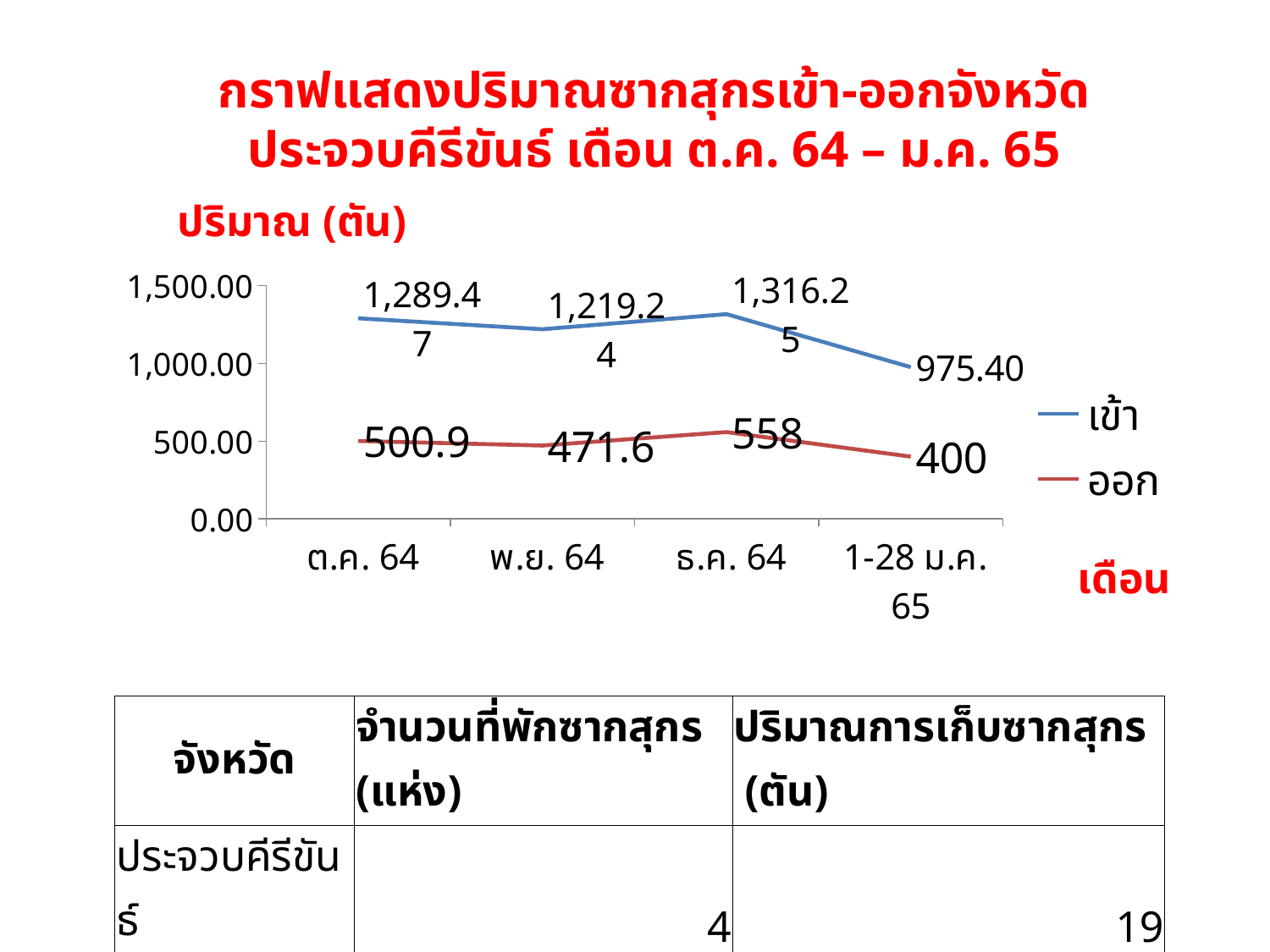
What is the difference between เข้า and ออก in ธ.ค. 64? 758.25 What is the value of ออก for พ.ย. 64? 471.6 How many series does the legend list? 2 What is the value of เข้า for 1-28 ม.ค. 65? 975.40 What is the value of เข้า for ต.ค. 64? 1,289.47 In which month is the เข้า series highest? ธ.ค. 64 Does the เข้า series rise or fall from ธ.ค. 64 to 1-28 ม.ค. 65? fall What is the label of the y axis? ปริมาณ (ตัน) What kind of chart is shown on the slide? line chart How many months (categories) are plotted on the x axis? 4 Which is larger, ออก in ต.ค. 64 or ออก in ธ.ค. 64? ธ.ค. 64 In which month is the ออก series lowest? 1-28 ม.ค. 65